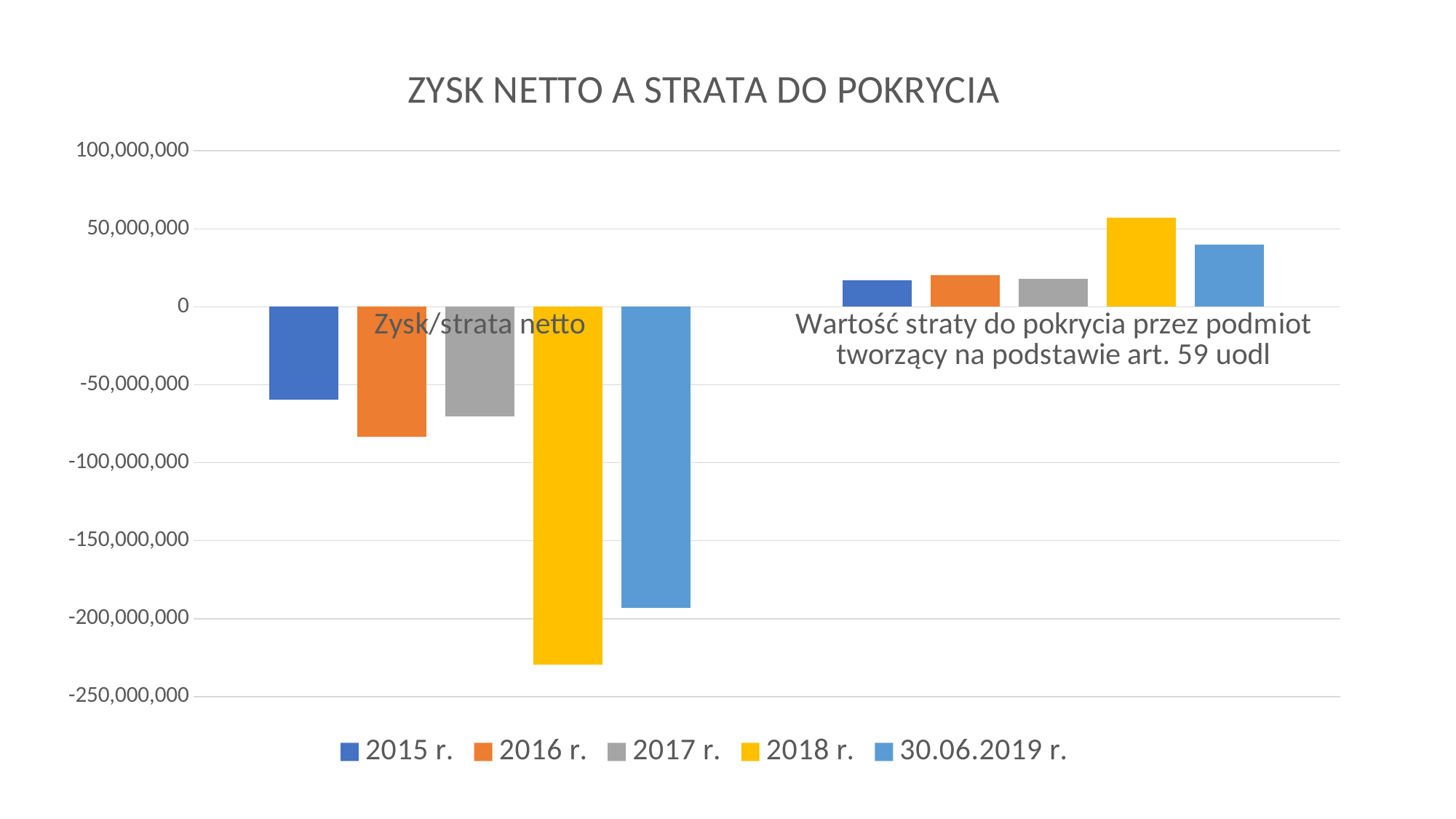
Which legend entry is shown in yellow? 2018 r. Which series has the highest value in the Wartość straty do pokrycia przez podmiot tworzący na podstawie art. 59 uodl category? 2018 r. Is the value for 2018 r. in the Wartość straty do pokrycia przez podmiot tworzący na podstawie art. 59 uodl category greater or less than 50,000,000? greater Is the value for 2015 r. in the Zysk/strata netto category greater or less than -50,000,000? less How many categories are shown on the x axis? 2 How many series does the legend list? 5 What kind of chart is shown on the slide? bar chart Is the value for 30.06.2019 r. in the Zysk/strata netto category greater or less than -150,000,000? less What is the title of the chart? ZYSK NETTO A STRATA DO POKRYCIA In the Zysk/strata netto category, which is larger, the value for 2015 r. or the value for 2016 r.? 2015 r. Which series has the lowest value in the Zysk/strata netto category? 2018 r.